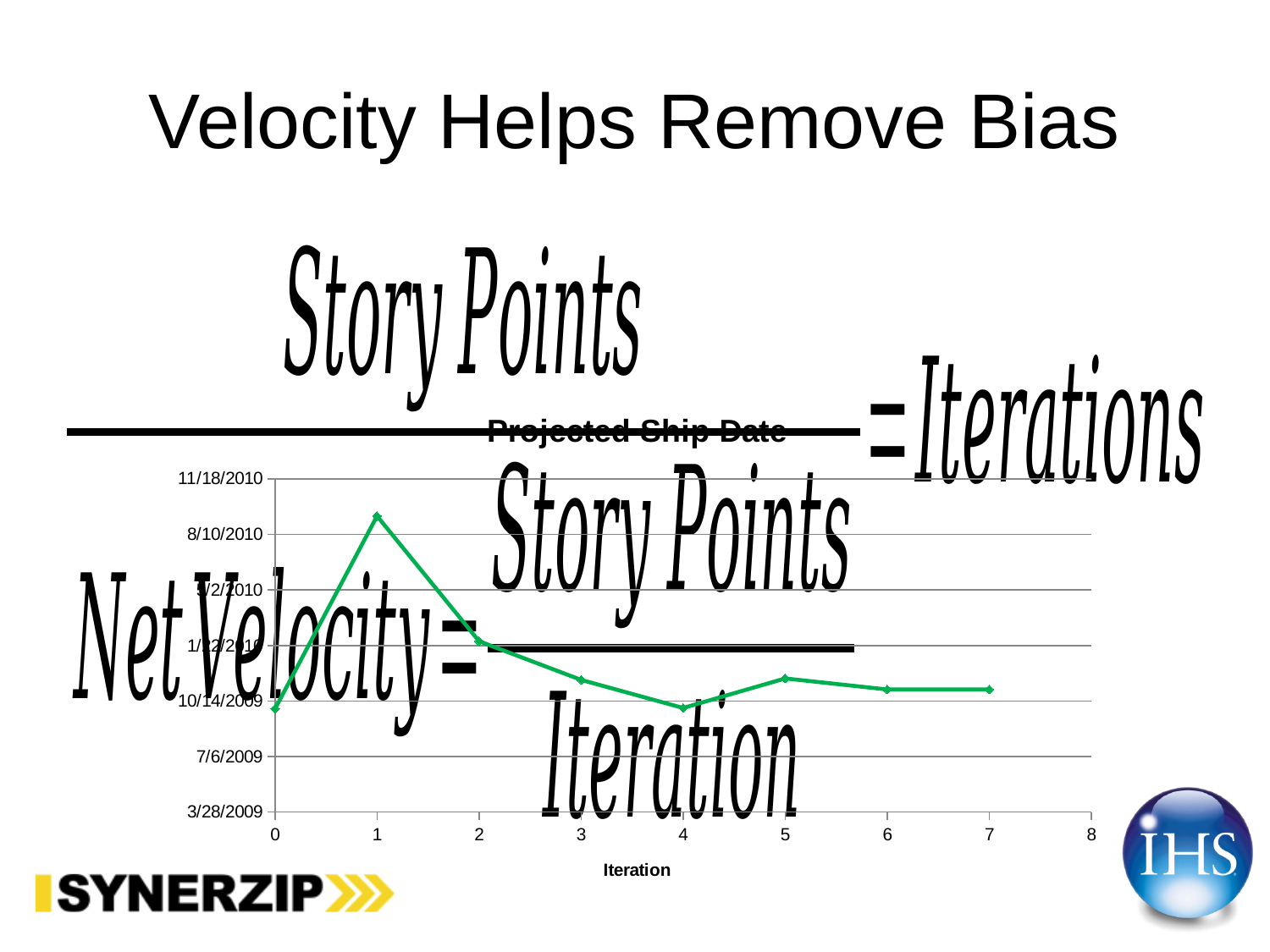
At which iteration is the projected ship date the latest? 1 Which has the later projected ship date, iteration 3 or iteration 4? iteration 3 What kind of chart is shown on the slide? line chart Which has the later projected ship date, iteration 1 or iteration 2? iteration 1 How many data points are plotted on the line? 8 Is the projected ship date at iteration 7 earlier or later than 10/14/2009? later Is the projected ship date at iteration 3 earlier or later than 1/12/2010? earlier Is the projected ship date at iteration 0 earlier or later than 1/12/2010? earlier Does the projected ship date rise or fall from iteration 0 to iteration 1? rise Does the projected ship date rise or fall from iteration 1 to iteration 4? fall What is the title of the chart? Projected Ship Date What is the label of the x axis of the chart? Iteration